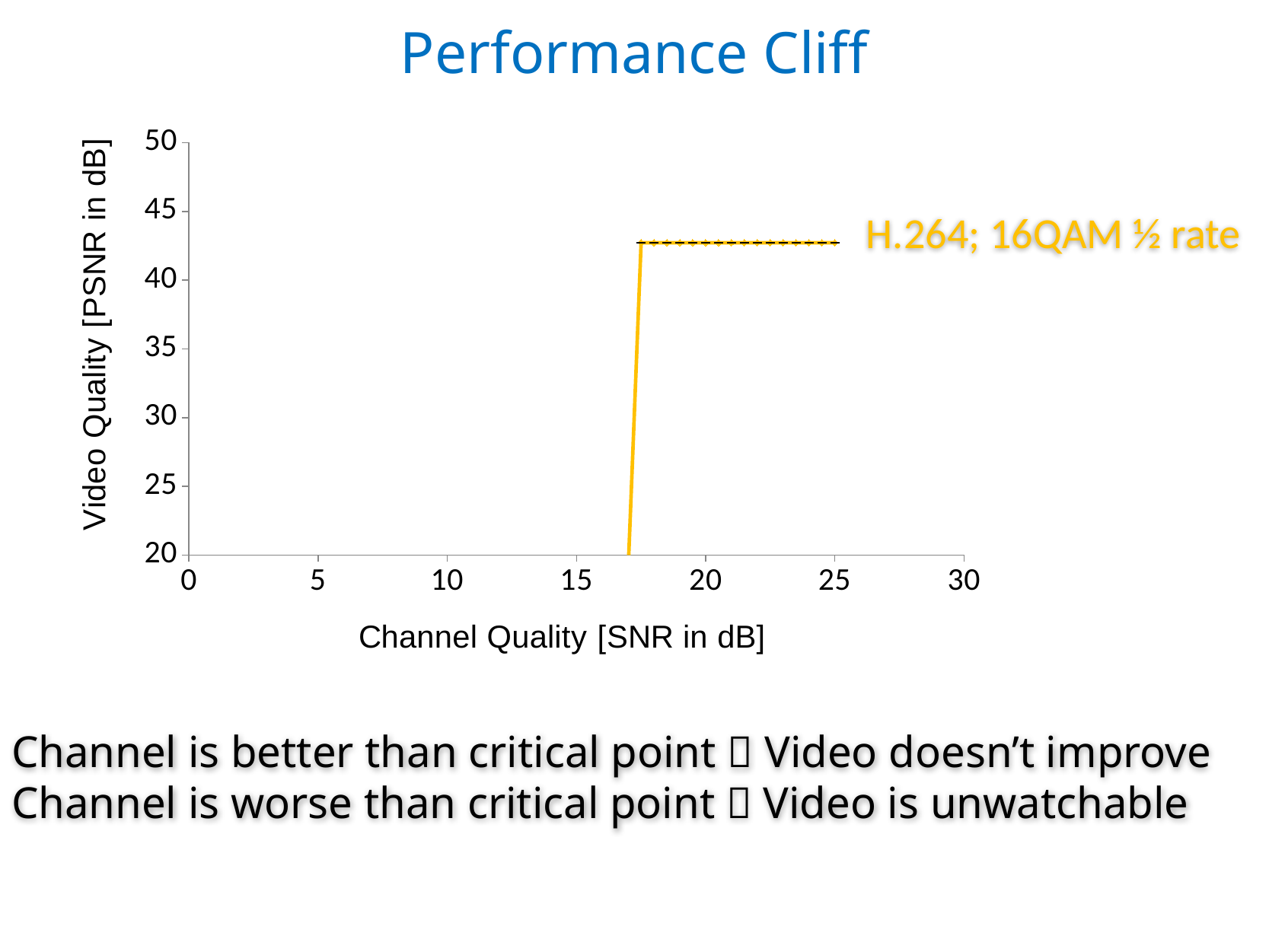
How many data series are plotted on the chart? 1 Is the video quality at a channel quality of 22 dB greater or less than 35? greater Is the video quality at a channel quality of 25 dB greater or less than 45? less Between channel quality 20 dB and 25 dB, does the video quality rise, fall, or stay flat? stay flat As channel quality increases from about 17 dB to 18 dB, does the video quality rise or fall? rise What is the title of the x axis? Channel Quality [SNR in dB] Is the video quality at 25 dB higher than, lower than, or about the same as at 20 dB? about the same Is the video quality at a channel quality of 20 dB greater or less than 40? greater What is the label of the plotted series? H.264; 16QAM ½ rate What kind of chart is shown on the slide? line chart